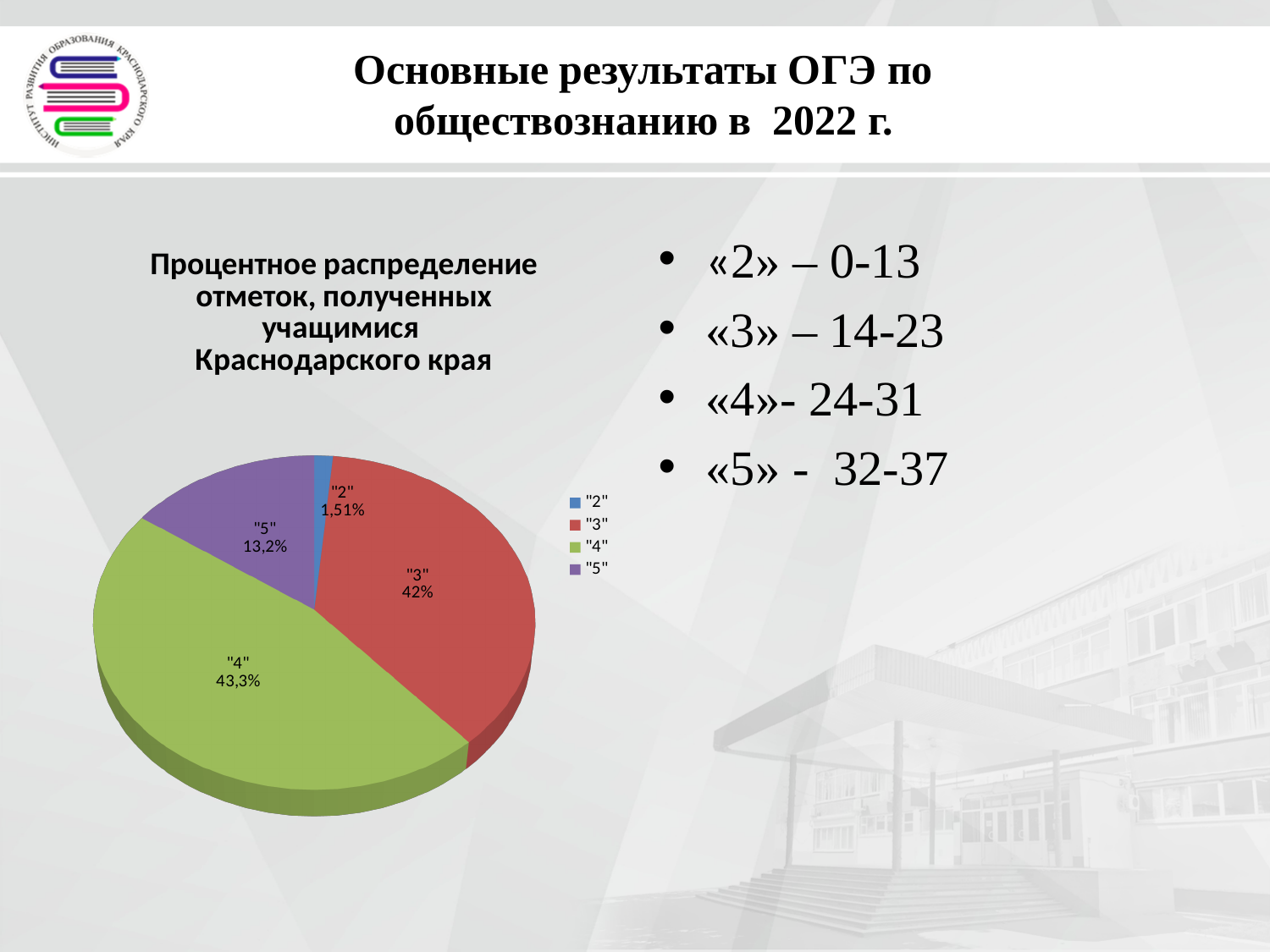
What type of chart is shown on the slide? Pie chart What colour is the slice for grade "3" in the pie chart? Red What percentage of the pie chart is the slice for grade "3"? 42% Which grade has the largest slice in the pie chart? "4" What percentage is shown for grade "5" in the pie chart? 13,2% What percentage is shown for grade "2" in the pie chart? 1,51% Which slice is larger in the pie chart: grade "5" or grade "2"? "5" Which grade has the smallest slice in the pie chart? "2" How many slices does the pie chart have? 4 What percentage is shown for grade "4" in the pie chart? 43,3% By how many percentage points does the share for grade "4" exceed the share for grade "3"? 1,3 What is the difference in percentage points between the shares for grade "3" and grade "5"? 28,8